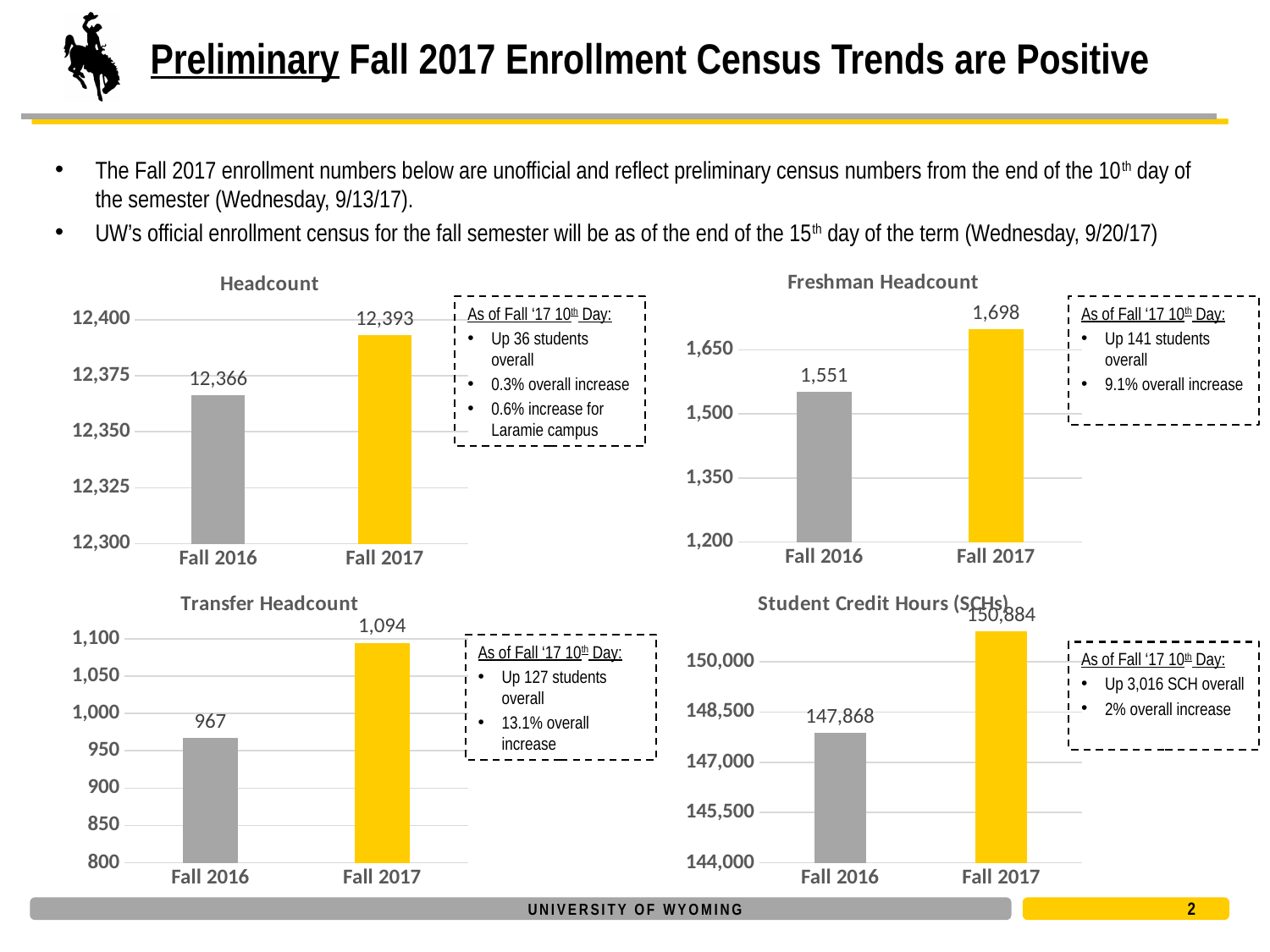
In the Student Credit Hours (SCHs) chart, what is the value for Fall 2016? 147,868 In the Transfer Headcount chart, which category has the highest value? Fall 2017 In the Headcount chart, is the value for Fall 2016 greater or less than 12,375? less In the Freshman Headcount chart, what is the difference between Fall 2017 and Fall 2016? 147 In the Headcount chart, what is the value for Fall 2017? 12,393 In the Headcount chart, what is the value for Fall 2016? 12,366 What kind of chart is the Transfer Headcount chart? bar chart In the Transfer Headcount chart, what is the difference between Fall 2017 and Fall 2016? 127 How many categories does the Freshman Headcount chart show? 2 In the Freshman Headcount chart, what is the value for Fall 2017? 1,698 In the Transfer Headcount chart, what is the value for Fall 2016? 967 In the Student Credit Hours (SCHs) chart, which is larger, Fall 2016 or Fall 2017? Fall 2017